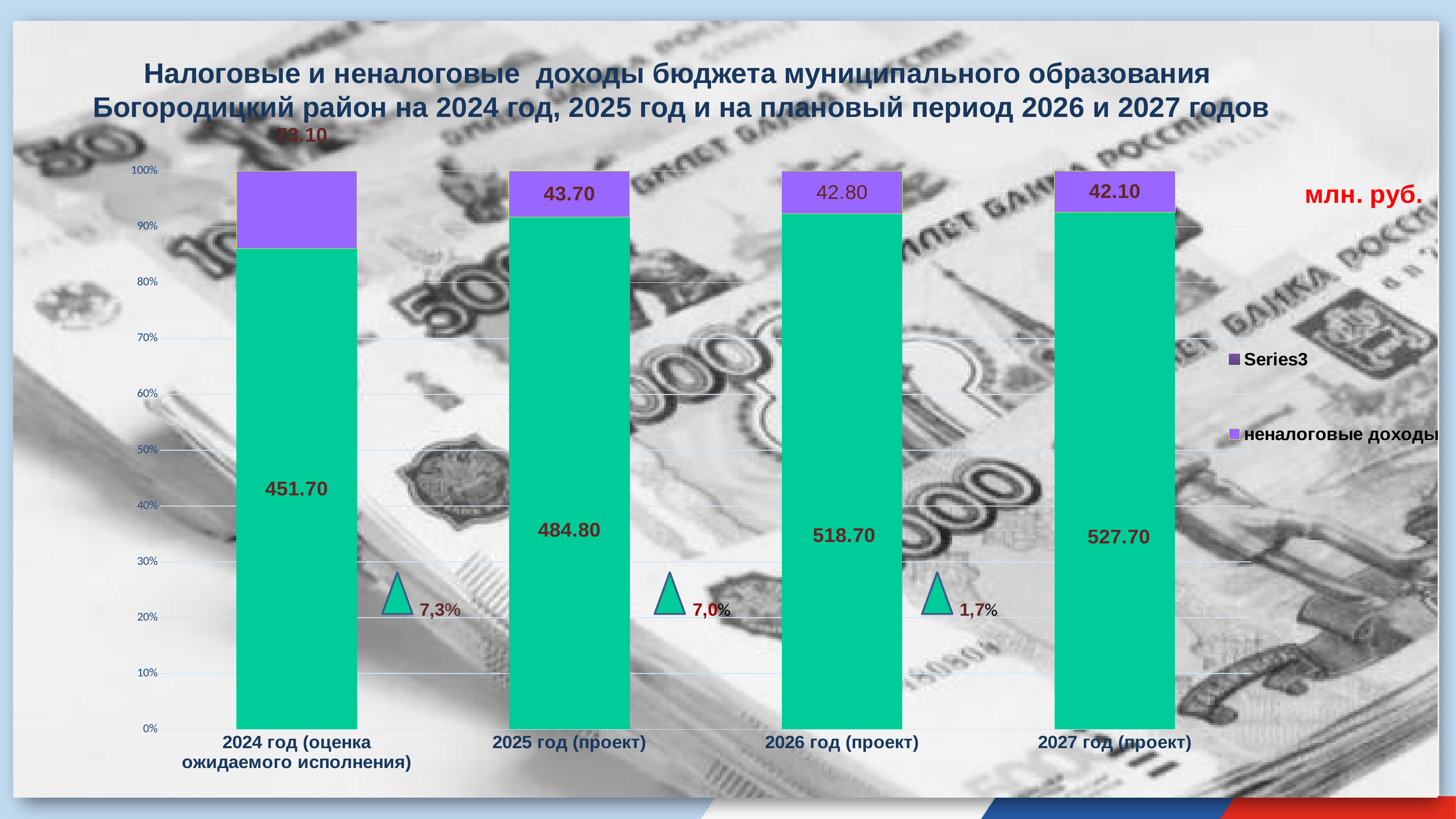
In which year is the value of неналоговые доходы the lowest? 2027 год (проект) What type of chart is shown on the slide? stacked bar chart Which is larger: the green segment value for 2026 год (проект) or for 2025 год (проект)? 2026 год (проект) Do the values of the green (lower) segment rise or fall from 2024 to 2027? rise What is the value of неналоговые доходы for 2024 год (оценка ожидаемого исполнения)? 73.10 How many year categories are shown on the x axis of the chart? 4 In which year is the value of неналоговые доходы the highest? 2024 год (оценка ожидаемого исполнения) What is the value of the green (lower) segment for 2027 год (проект)? 527.70 What is the difference between the неналоговые доходы values for 2024 год and 2025 год (проект)? 29.40 What is the total of the two segments for 2027 год (проект)? 569.80 What is the value of неналоговые доходы for 2026 год (проект)? 42.80 What is the value of the green (lower) segment for 2025 год (проект)? 484.80